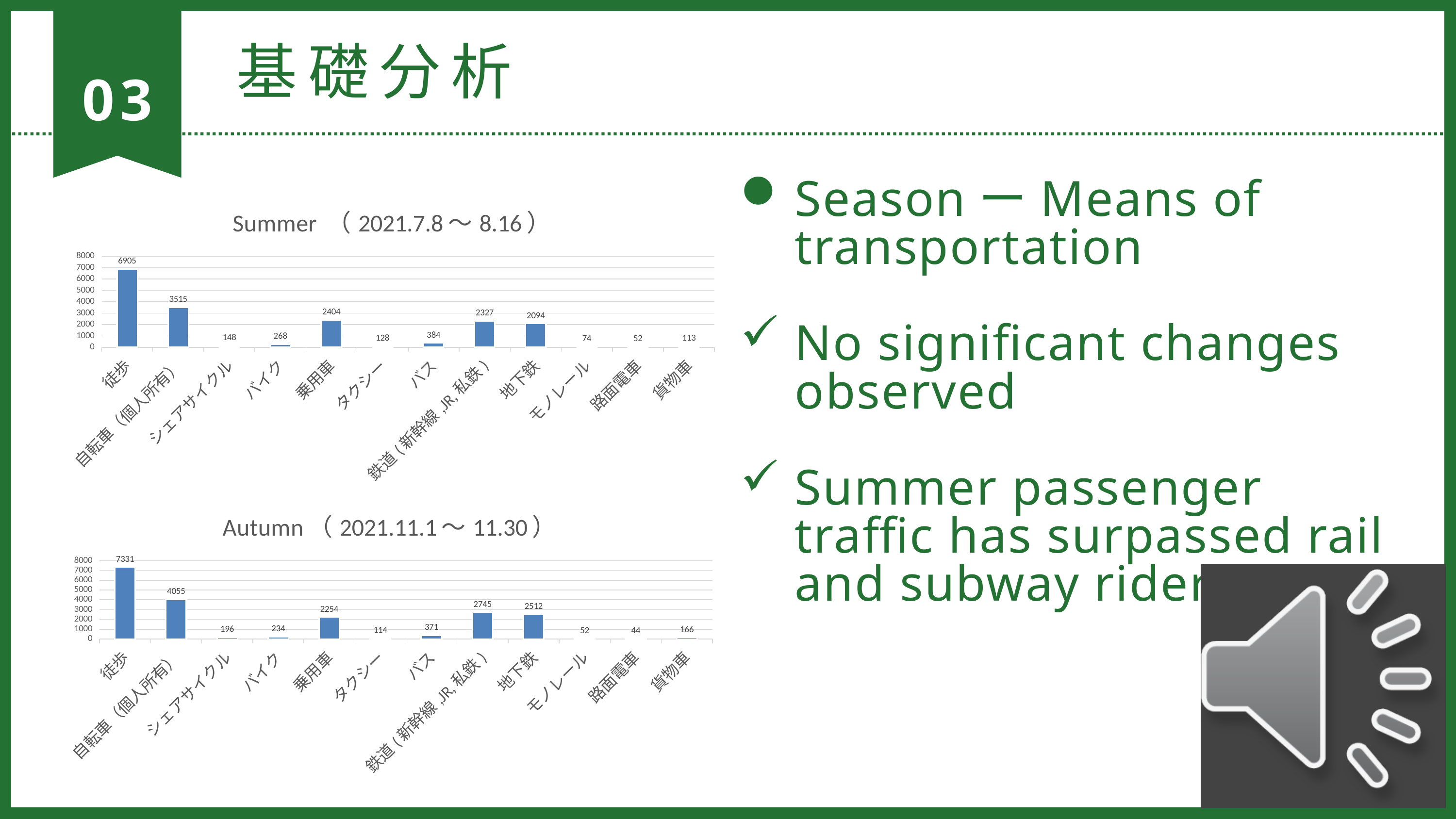
What kind of chart is the Autumn chart? bar chart In the Autumn chart, what is the difference between 徒歩 and 自転車（個人所有）? 3276 In the Summer chart, which category has the lowest value? 路面電車 In the Summer chart, which is larger, 乗用車 or 鉄道（新幹線, JR, 私鉄）? 乗用車 In the Autumn chart, which is larger, 鉄道（新幹線, JR, 私鉄） or 地下鉄? 鉄道（新幹線, JR, 私鉄） In the Summer chart, what is the value for バス? 384 In the Autumn chart, what is the value for 地下鉄? 2512 In the Autumn chart, which category has the highest value? 徒歩 How many categories are shown in the Summer chart? 12 In the Summer chart, what is the value for モノレール? 74 In the Summer chart, what is the value for 徒歩? 6905 What date range is shown in the title of the Autumn chart? 2021.11.1 〜 11.30